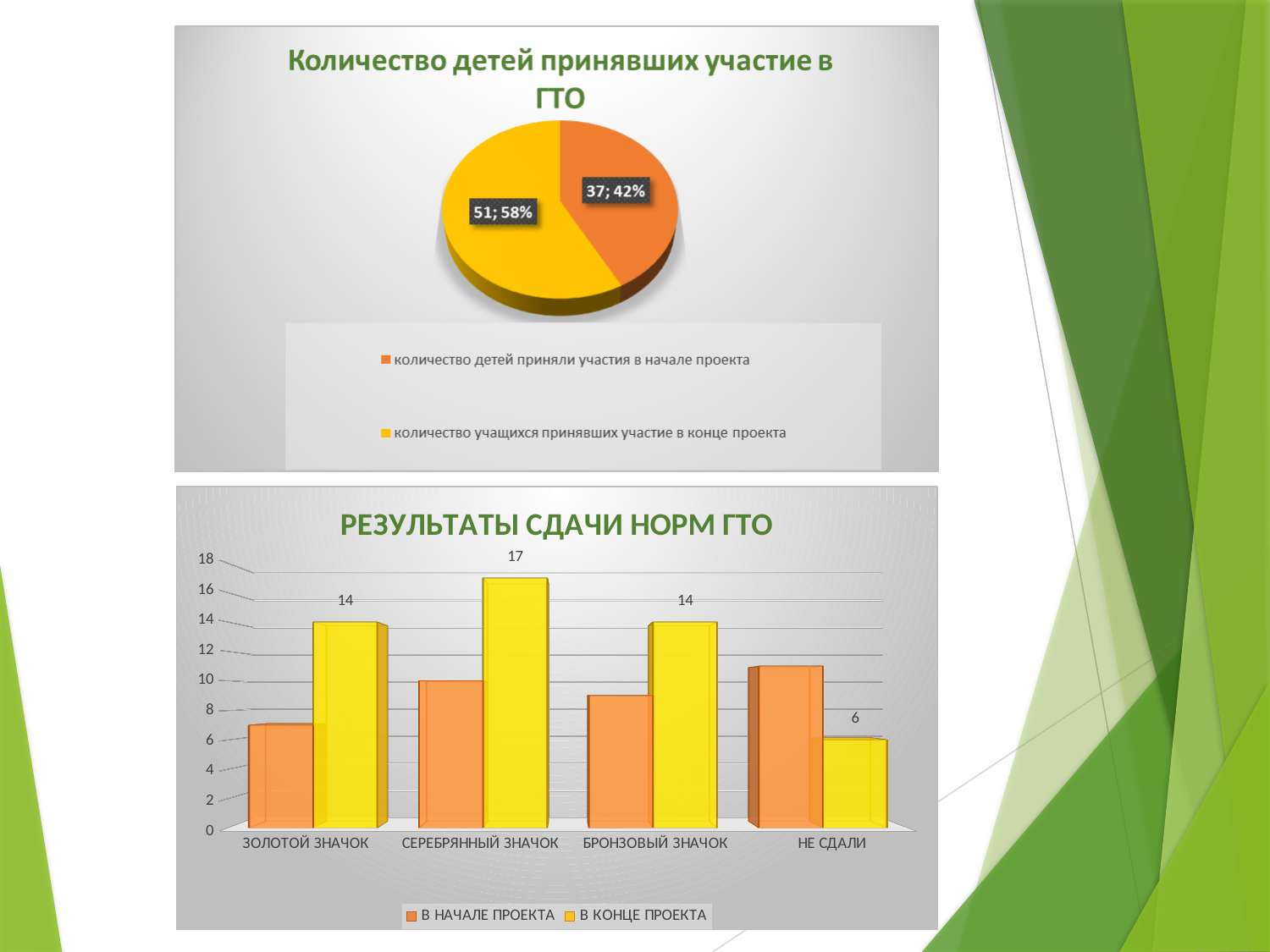
In the bar chart 'РЕЗУЛЬТАТЫ СДАЧИ НОРМ ГТО', how many series does the legend list? 2 In the bar chart 'РЕЗУЛЬТАТЫ СДАЧИ НОРМ ГТО', how many categories are shown on the x axis? 4 In the pie chart 'Количество детей принявших участие в ГТО', what value is shown for 'количество учащихся принявших участие в конце проекта'? 51 In the bar chart 'РЕЗУЛЬТАТЫ СДАЧИ НОРМ ГТО', is the value for 'СЕРЕБРЯННЫЙ ЗНАЧОК' in the series 'В НАЧАЛЕ ПРОЕКТА' greater or less than 8? greater In the pie chart 'Количество детей принявших участие в ГТО', what value is shown for 'количество детей приняли участия в начале проекта'? 37 What kind of chart is the top chart 'Количество детей принявших участие в ГТО'? pie chart In the bar chart 'РЕЗУЛЬТАТЫ СДАЧИ НОРМ ГТО', which category has the highest value in the series 'В КОНЦЕ ПРОЕКТА'? СЕРЕБРЯННЫЙ ЗНАЧОК In the bar chart 'РЕЗУЛЬТАТЫ СДАЧИ НОРМ ГТО', what is the value for 'СЕРЕБРЯННЫЙ ЗНАЧОК' in the series 'В КОНЦЕ ПРОЕКТА'? 17 In the bar chart 'РЕЗУЛЬТАТЫ СДАЧИ НОРМ ГТО', what is the value for 'НЕ СДАЛИ' in the series 'В КОНЦЕ ПРОЕКТА'? 6 In the bar chart 'РЕЗУЛЬТАТЫ СДАЧИ НОРМ ГТО', which category has the lowest value in the series 'В КОНЦЕ ПРОЕКТА'? НЕ СДАЛИ In the pie chart 'Количество детей принявших участие в ГТО', what share of the pie does the slice for the end of the project ('в конце проекта') take? 58% In the pie chart 'Количество детей принявших участие в ГТО', what is the difference between the number of children at the end of the project and at the start? 14